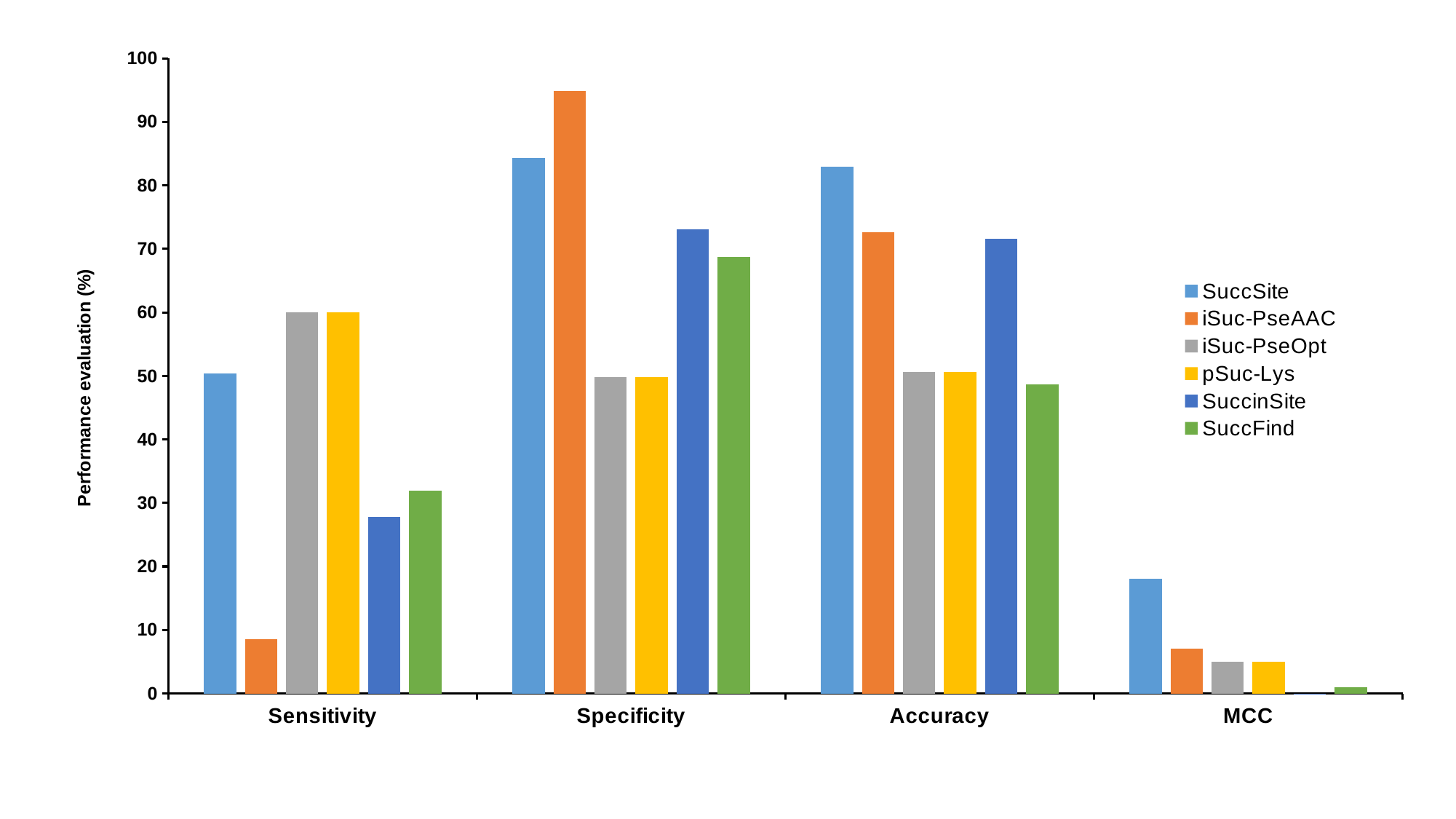
Is the Specificity value for SuccSite greater or less than 80? greater Which series has the highest value for Specificity? iSuc-PseAAC Which series has the highest value for Accuracy? SuccSite How many series does the legend list? 6 What is the label of the y axis? Performance evaluation (%) Which series has the lowest value for Sensitivity? iSuc-PseAAC For Sensitivity, which is larger: SuccinSite or SuccFind? SuccFind How many categories are shown on the x axis? 4 Which series has the highest value for MCC? SuccSite What kind of chart is shown on the slide? bar chart For Accuracy, which is larger: SuccSite or iSuc-PseAAC? SuccSite Is the Sensitivity value for SuccFind greater or less than 40? less